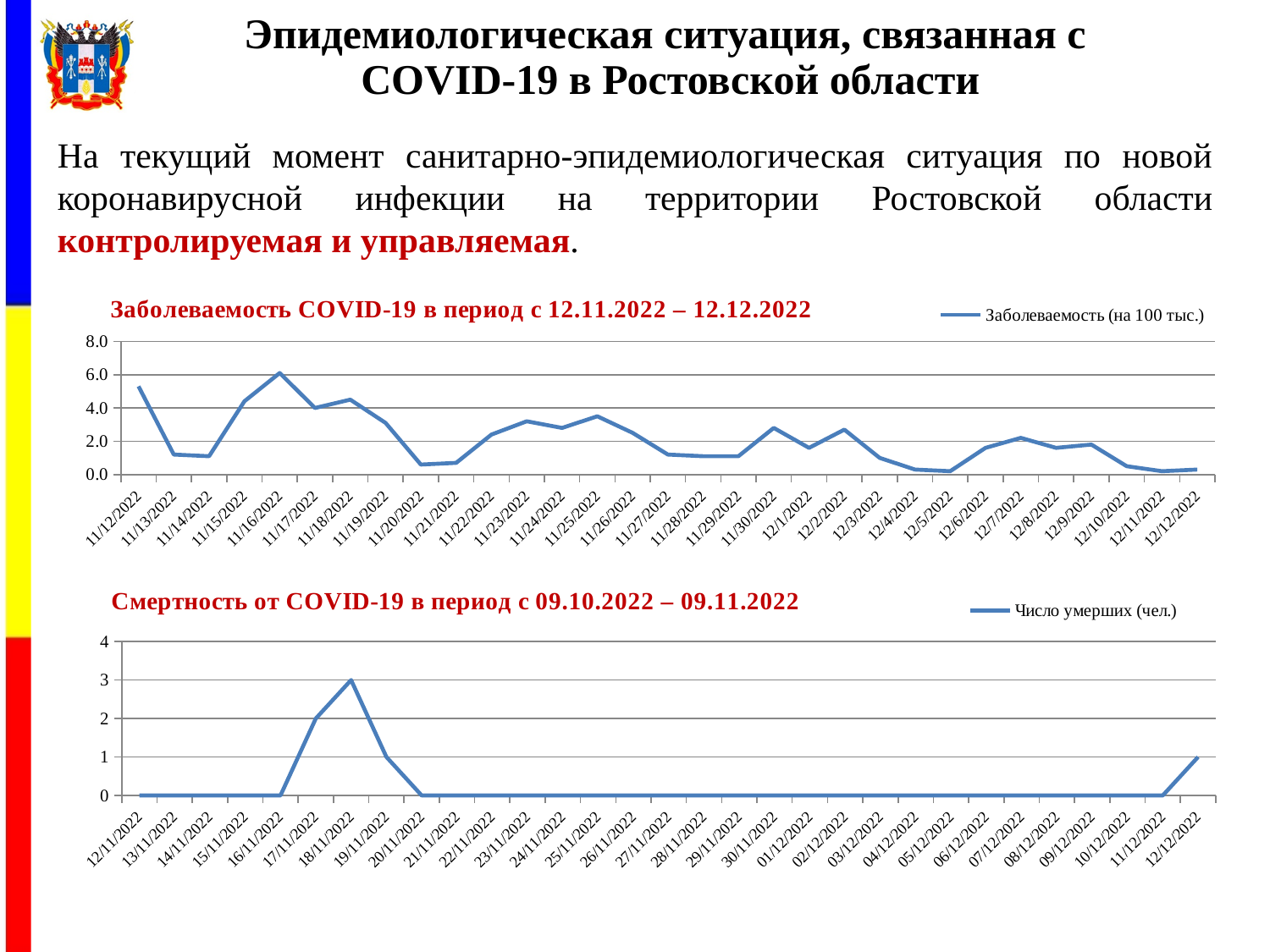
In the top chart (Заболеваемость COVID-19), on which date is the incidence highest? 11/16/2022 In the bottom chart (Смертность от COVID-19), how many series does the legend list? 1 In the top chart (Заболеваемость COVID-19), which date has the higher value: 11/16/2022 or 11/25/2022? 11/16/2022 In the bottom chart (Смертность от COVID-19), what is the number of deaths on 17/11/2022? 2 In the top chart (Заболеваемость COVID-19), is the value for 12/4/2022 greater or less than 1.0? less In the top chart (Заболеваемость COVID-19), is the value for 11/20/2022 greater or less than 1.0? less In the bottom chart (Смертность от COVID-19), what is the difference between the values for 18/11/2022 and 17/11/2022? 1 In the top chart (Заболеваемость COVID-19), is the value for 11/12/2022 greater or less than 4.0? greater In the top chart (Заболеваемость COVID-19), does the incidence overall rise or fall from 11/12/2022 to 12/12/2022? fall In the top chart (Заболеваемость COVID-19), what is the legend entry for the plotted series? Заболеваемость (на 100 тыс.) In the bottom chart (Смертность от COVID-19), what is the number of deaths on 18/11/2022? 3 What kind of chart is the top chart titled "Заболеваемость COVID-19 в период с 12.11.2022 – 12.12.2022"? line chart